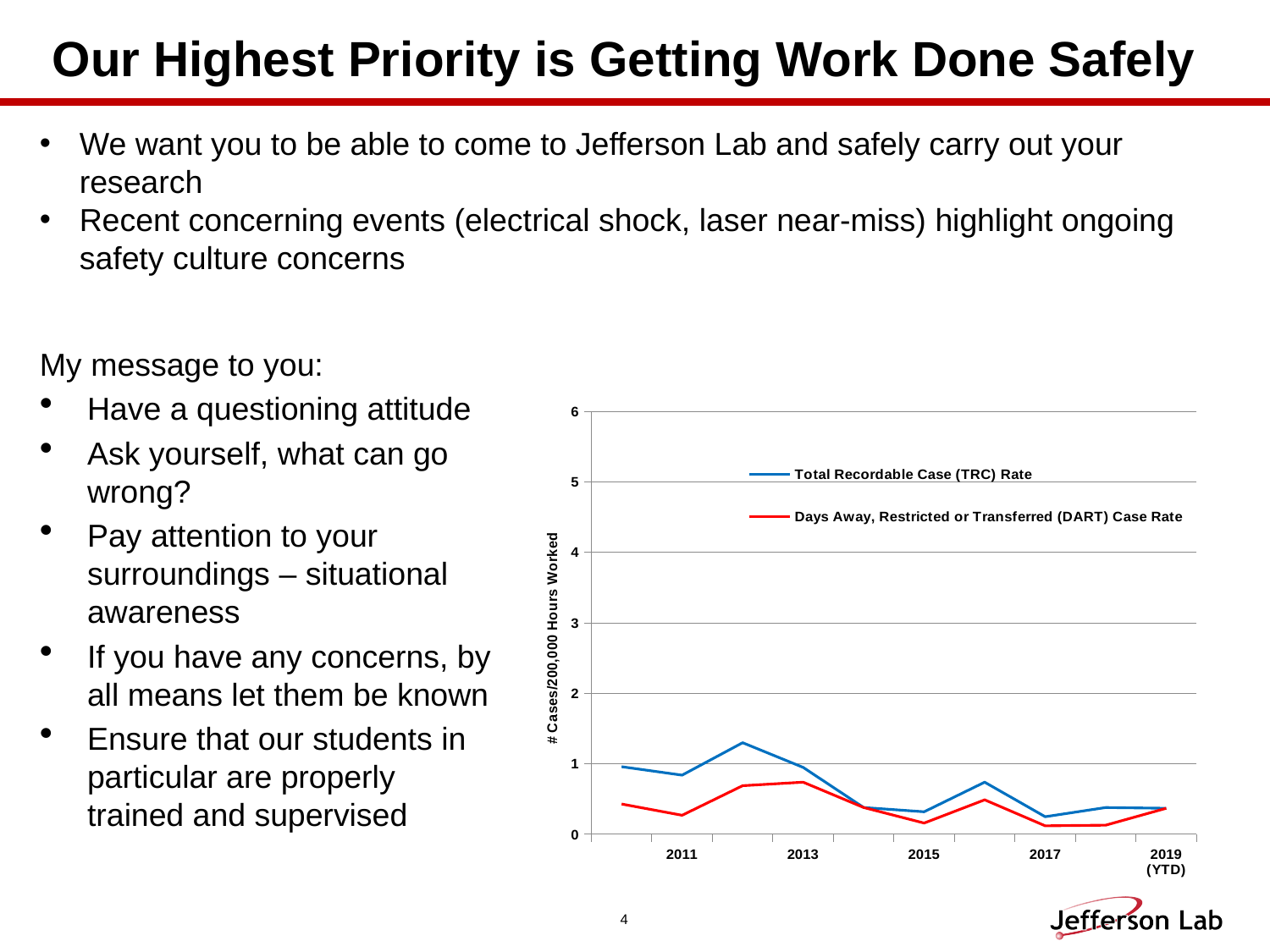
In 2011, which series has the higher value, the TRC Rate or the DART Case Rate? Total Recordable Case (TRC) Rate Is the Total Recordable Case (TRC) Rate in 2013 greater or less than 2? less Among the labeled years (2011, 2013, 2015, 2017, 2019), in which year is the TRC Rate highest? 2013 Is the DART Case Rate in 2015 greater or less than 1? less What are the two series named in the chart's legend? Total Recordable Case (TRC) Rate; Days Away, Restricted or Transferred (DART) Case Rate What is the label on the chart's vertical axis? # Cases/200,000 Hours Worked Does the Total Recordable Case (TRC) Rate rise or fall from 2013 to 2015? fall In 2013, which series has the higher value, the TRC Rate or the DART Case Rate? Total Recordable Case (TRC) Rate What is the highest value shown on the chart's vertical axis? 6 What kind of chart is shown on the slide? line chart Is the Total Recordable Case (TRC) Rate in 2017 greater or less than 1? less How many series does the chart's legend list? 2